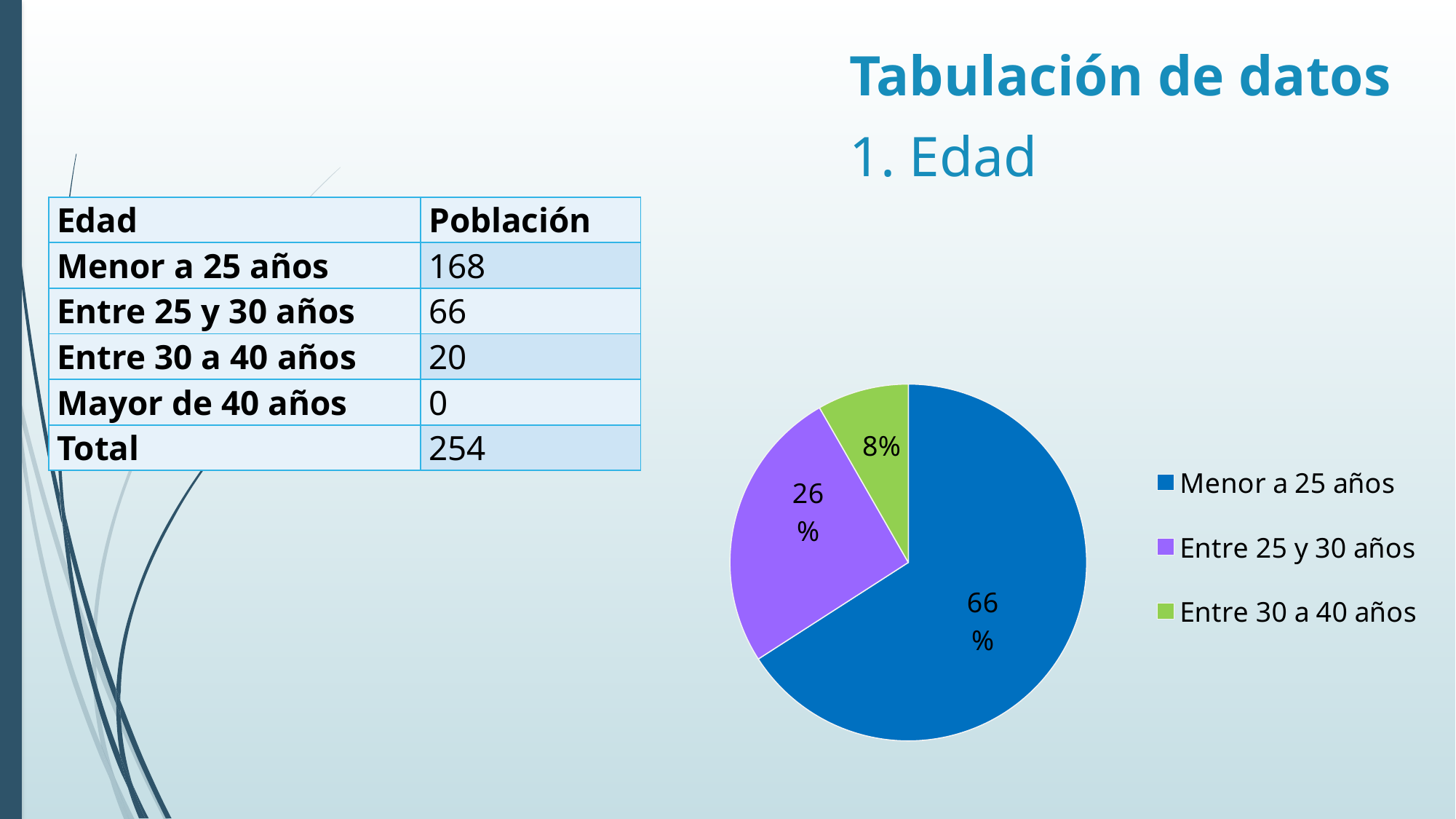
What kind of chart is shown on the slide? pie chart What share of the pie does the 'Entre 25 y 30 años' slice represent? 26% What colour is the 'Entre 30 a 40 años' slice in the pie chart? green Which slice is larger, 'Entre 25 y 30 años' or 'Entre 30 a 40 años'? Entre 25 y 30 años How many entries does the legend list? 3 What is the difference in percentage points between the 'Menor a 25 años' slice and the 'Entre 25 y 30 años' slice? 40% What colour is the 'Entre 25 y 30 años' slice in the pie chart? purple Which category has the largest slice of the pie? Menor a 25 años Which category has the smallest slice of the pie? Entre 30 a 40 años What share of the pie does the 'Entre 30 a 40 años' slice represent? 8% What share of the pie does the 'Menor a 25 años' slice represent? 66% How many slices does the pie chart have? 3